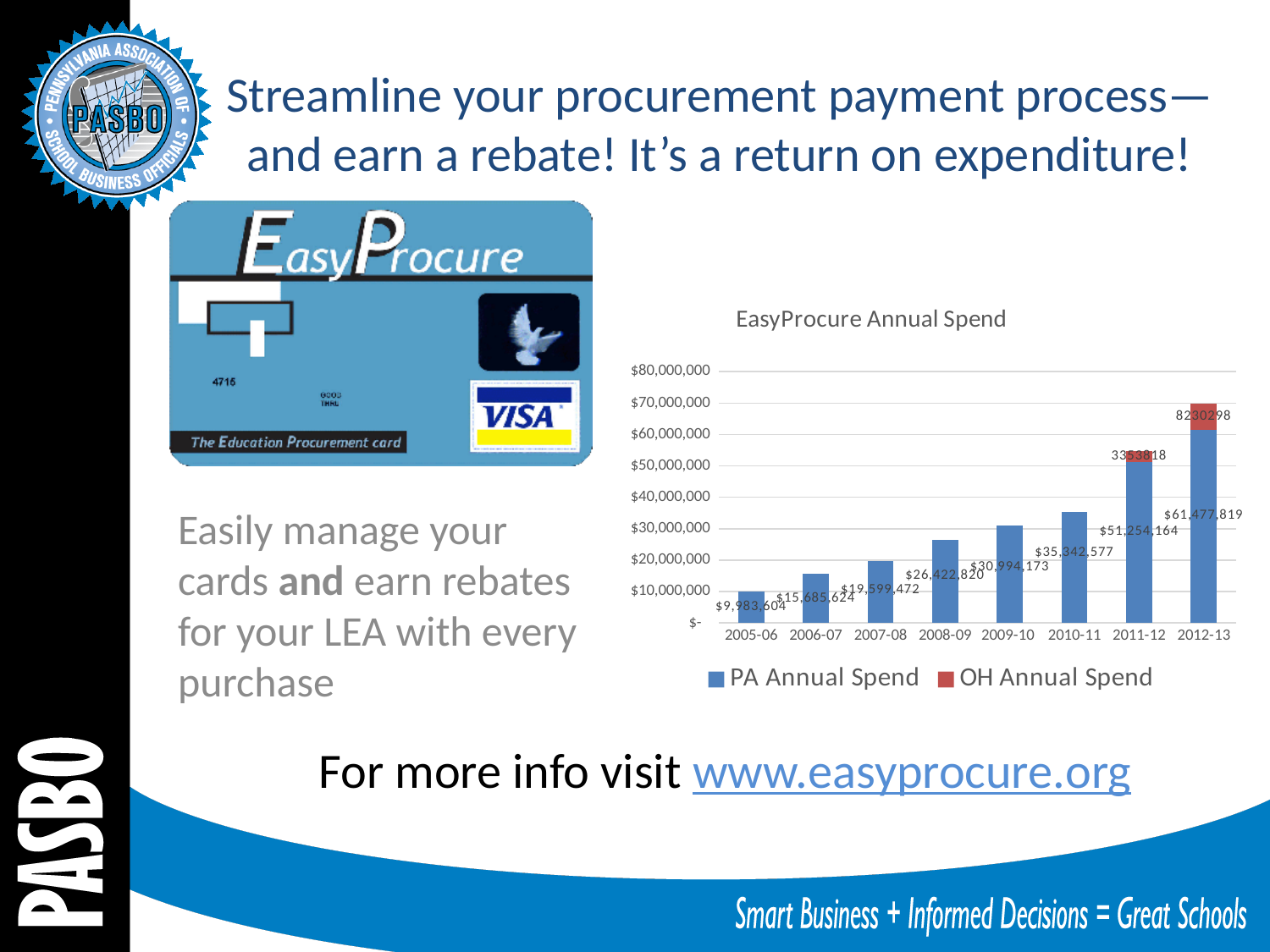
Which year has the lowest PA Annual Spend? 2005-06 How many fiscal years are shown on the x axis of the chart? 8 Which is larger, the PA Annual Spend in 2007-08 or in 2008-09? 2008-09 Which year has the highest PA Annual Spend? 2012-13 What is the PA Annual Spend for 2009-10? $30,994,173 How many series does the chart legend list? 2 Does the PA Annual Spend rise or fall from 2005-06 to 2012-13? rise What type of chart is shown on the slide? bar chart What is the difference between the PA Annual Spend in 2012-13 and in 2011-12? $10,223,655 What is the PA Annual Spend for 2005-06? $9,983,604 What is the PA Annual Spend for 2012-13? $61,477,819 What is the title of the chart? EasyProcure Annual Spend